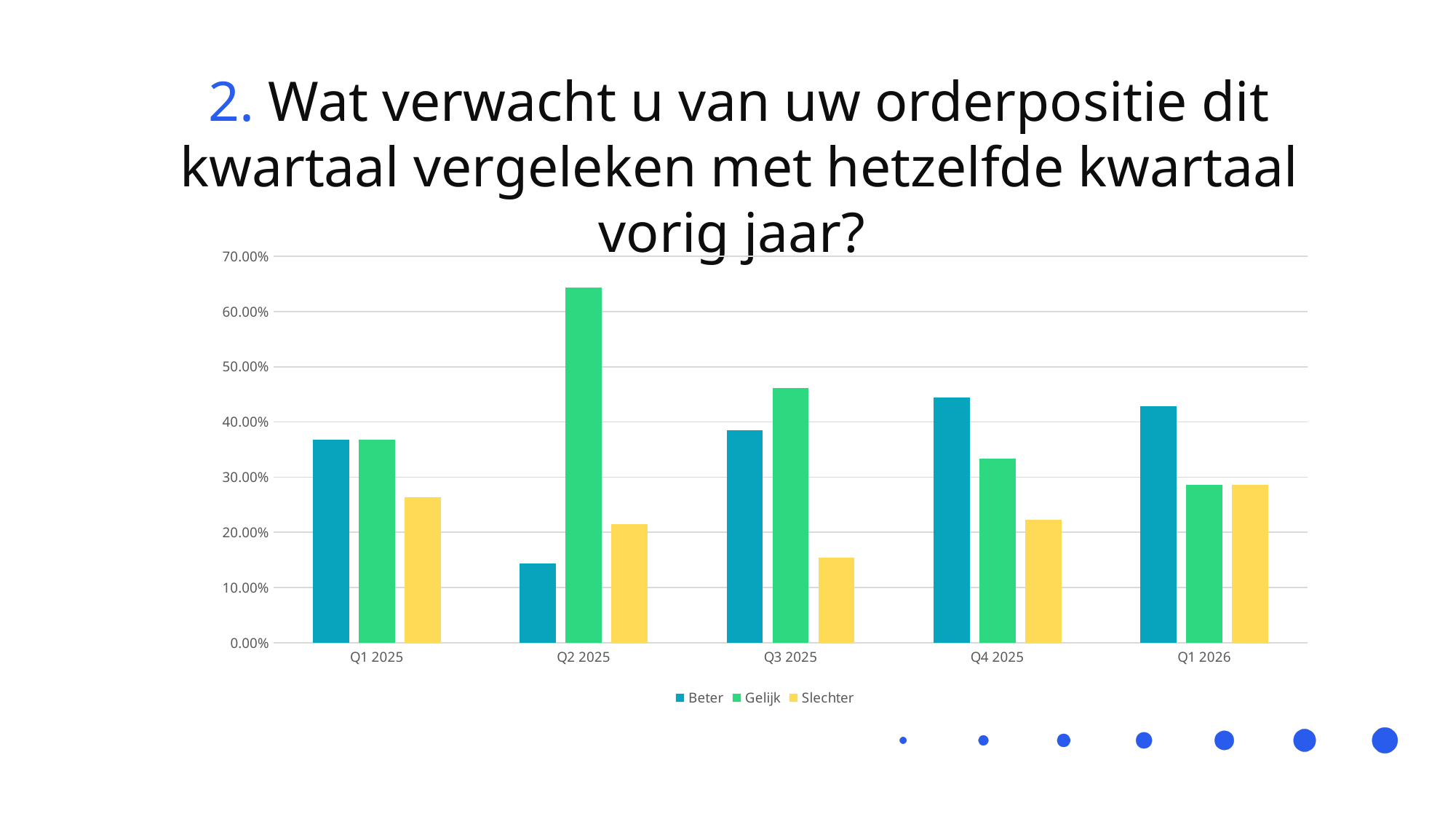
In which quarter is the value for Slechter the lowest? Q3 2025 In Q3 2025, which is larger: Beter or Gelijk? Gelijk How many series does the legend list? 3 How many quarters are shown on the x axis? 5 Does the value for Beter rise or fall from Q2 2025 to Q4 2025? rise Is the value for Slechter in Q3 2025 greater or less than 20.00%? less Is the value for Beter in Q2 2025 greater or less than 20.00%? less In Q4 2025, which is larger: Beter or Gelijk? Beter In which quarter is the value for Beter the lowest? Q2 2025 In which quarter is the value for Gelijk the highest? Q2 2025 What kind of chart is shown on the slide? bar chart Is the value for Gelijk in Q2 2025 greater or less than 60.00%? greater